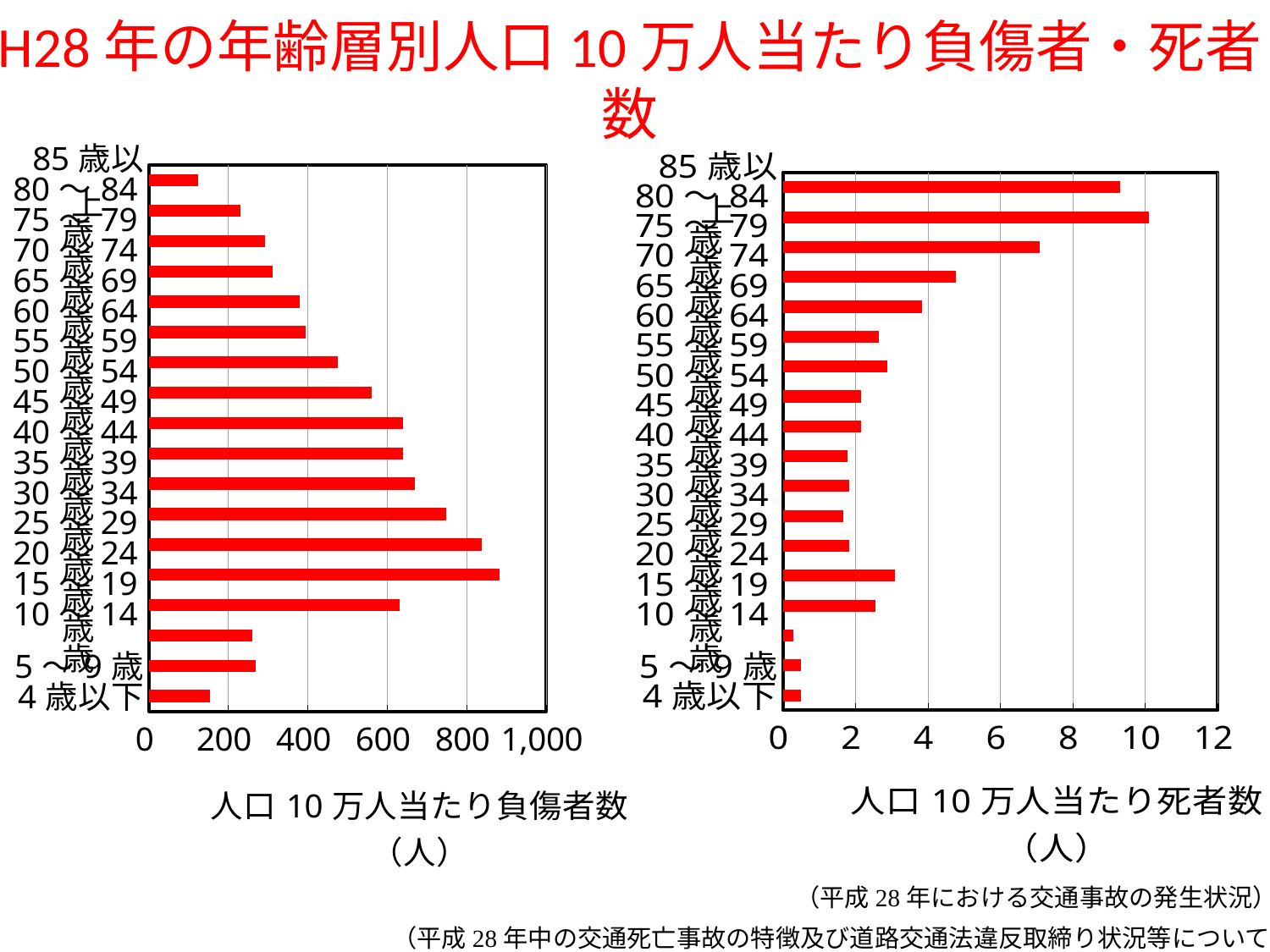
In the left chart (人口10万人当たり負傷者数), which is larger, the value for 20～24歳 or 25～29歳? 20～24歳 What kind of chart is the left chart (人口10万人当たり負傷者数)? bar chart In the left chart (人口10万人当たり負傷者数), is the value for 15～19歳 greater or less than 800? less In the right chart (人口10万人当たり死者数), is the value for 85歳以上 greater or less than 8? greater How many age groups are shown in the left chart (人口10万人当たり負傷者数)? 18 In the right chart (人口10万人当たり死者数), is the value for 75～79歳 greater or less than 6? greater What is the x-axis title of the right chart? 人口10万人当たり死者数（人） In the left chart (人口10万人当たり負傷者数), which age group has the highest value? 20～24歳 In the right chart (人口10万人当たり死者数), which age group has the highest value? 80～84歳 In the right chart (人口10万人当たり死者数), which is larger, the value for 15～19歳 or 10～14歳? 15～19歳